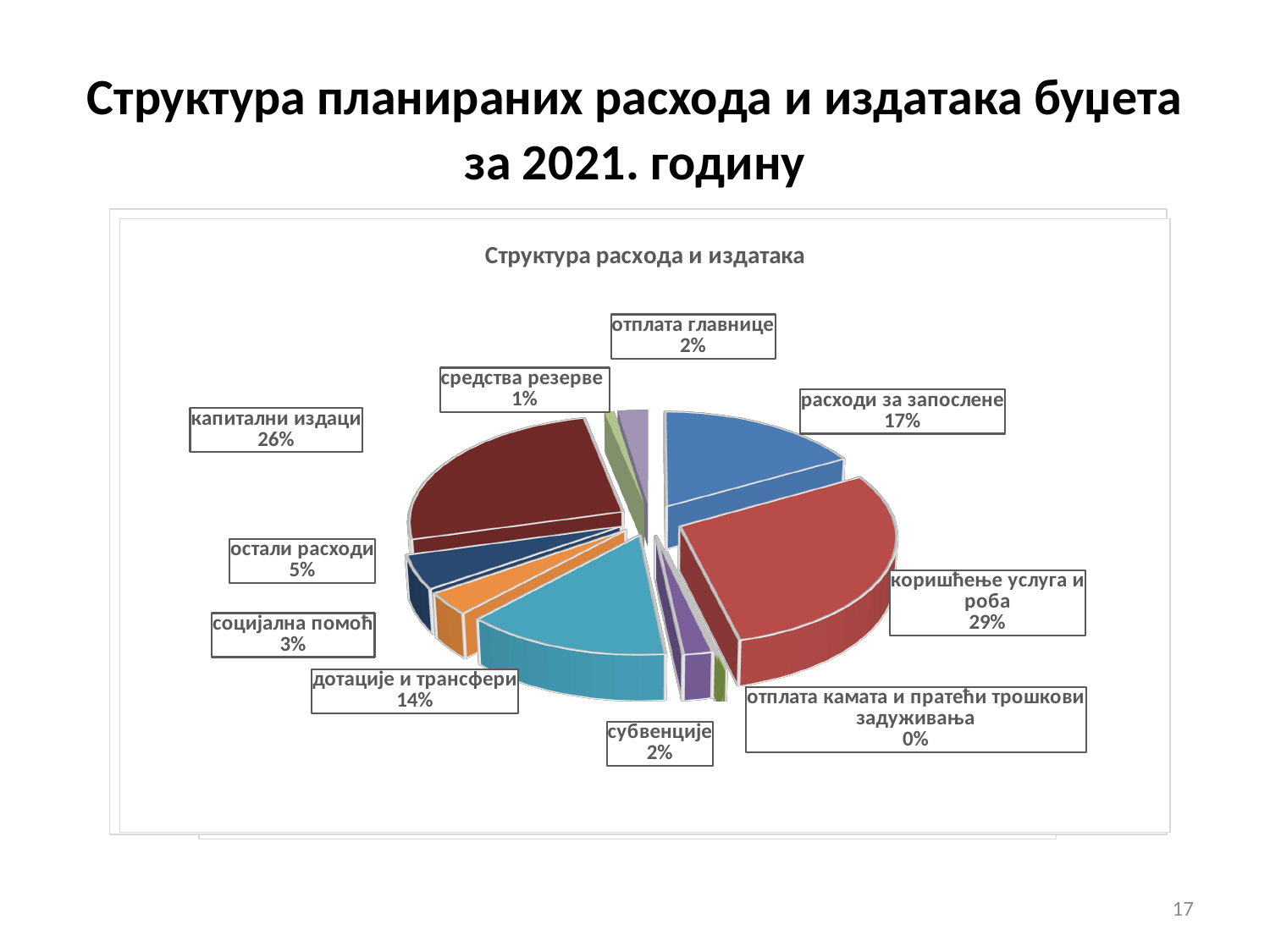
What share of the pie does коришћење услуга и роба have? 29% Which category has the largest share of the pie? коришћење услуга и роба Which category has the smallest share of the pie? отплата камата и пратећи трошкови задуживања What is the difference in percentage points between коришћење услуга и роба and капитални издаци? 3 What is the value shown for расходи за запослене? 17% What is the value shown for дотације и трансфери? 14% What is the title of the chart? Структура расхода и издатака Which is larger, the share for расходи за запослене or the share for дотације и трансфери? расходи за запослене What share of the pie does капитални издаци have? 26% How many categories are shown in the pie chart? 10 What is the value shown for остали расходи? 5% What kind of chart is shown on the slide? pie chart